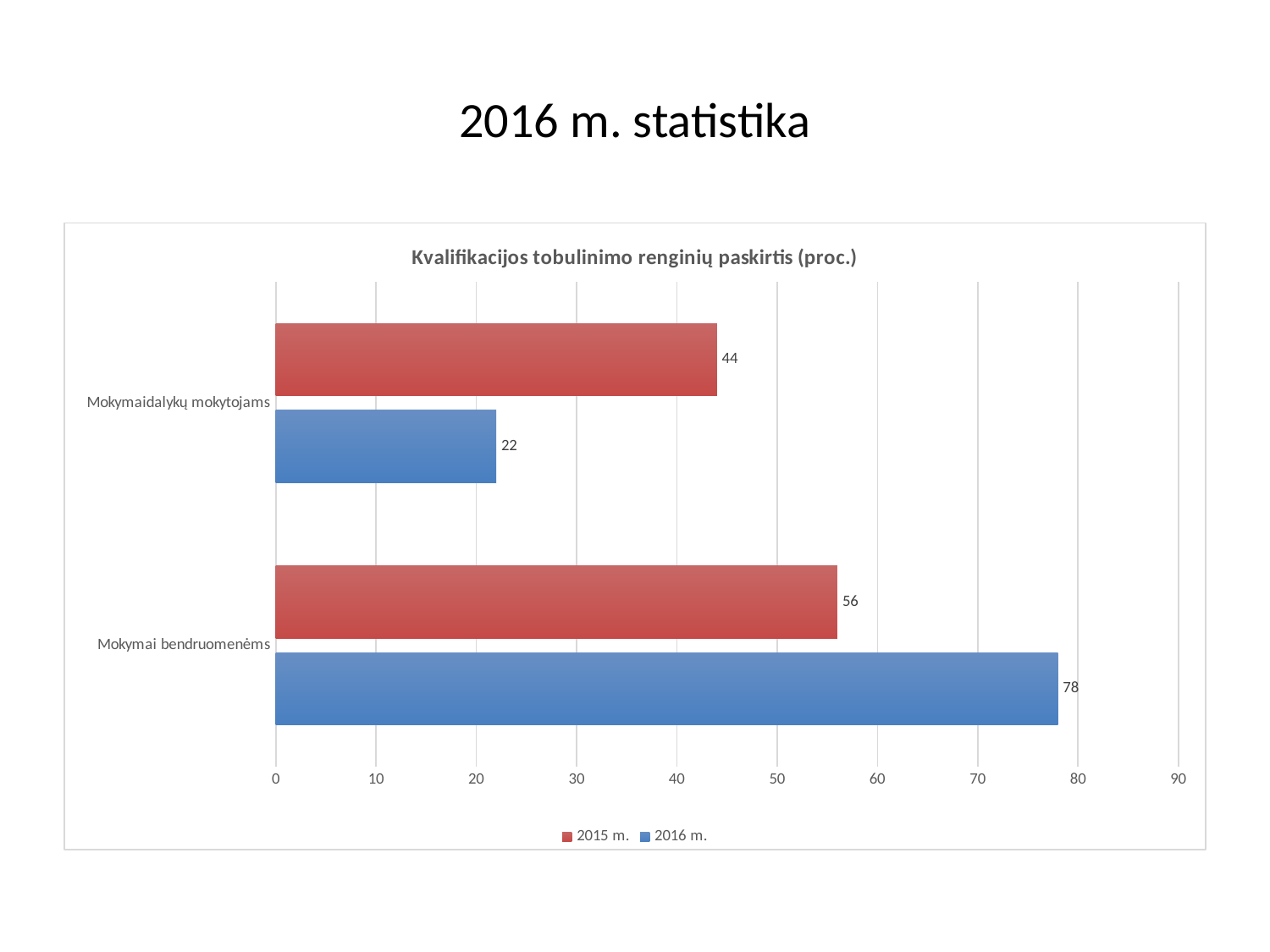
What is the value for 2015 m. for Mokymaidalykų mokytojams? 44 What is the value for 2016 m. for Mokymai bendruomenėms? 78 What is the value for 2016 m. for Mokymaidalykų mokytojams? 22 What is the difference between the 2016 m. and 2015 m. values for Mokymai bendruomenėms? 22 Which category has the highest value for 2016 m.? Mokymai bendruomenėms How many categories are shown on the chart? 2 What kind of chart is shown on the slide? Bar chart What is the value for 2015 m. for Mokymai bendruomenėms? 56 Which is larger for Mokymaidalykų mokytojams: the 2015 m. value or the 2016 m. value? 2015 m. How many series does the legend list? 2 Which category has the lowest value for 2015 m.? Mokymaidalykų mokytojams What is the title of the chart? Kvalifikacijos tobulinimo renginių paskirtis (proc.)